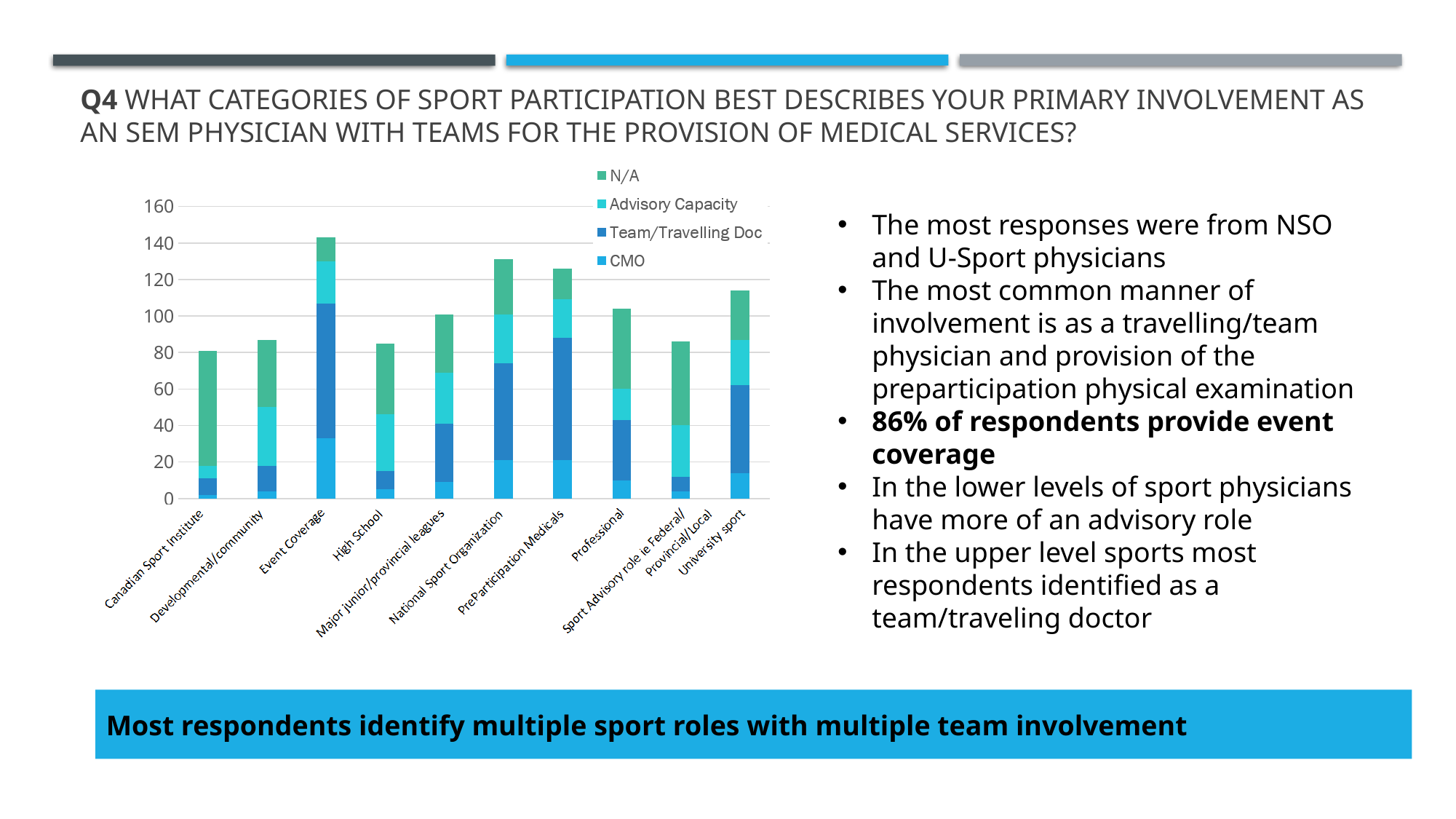
Is the total for High School greater or less than 100? less Which series in the legend is shown in the darkest blue colour? Team/Travelling Doc How many categories are shown along the x axis of the chart? 10 What kind of chart is shown on the slide? Stacked bar chart Is the total for Event Coverage greater or less than 120? greater Is the total for National Sport Organization greater or less than 120? greater Which has the taller stacked bar, PreParticipation Medicals or Professional? PreParticipation Medicals How many series does the chart legend list? 4 Which category has the tallest stacked bar in the chart? Event Coverage Which series is listed first in the chart legend? N/A Which has the taller stacked bar, National Sport Organization or University sport? National Sport Organization